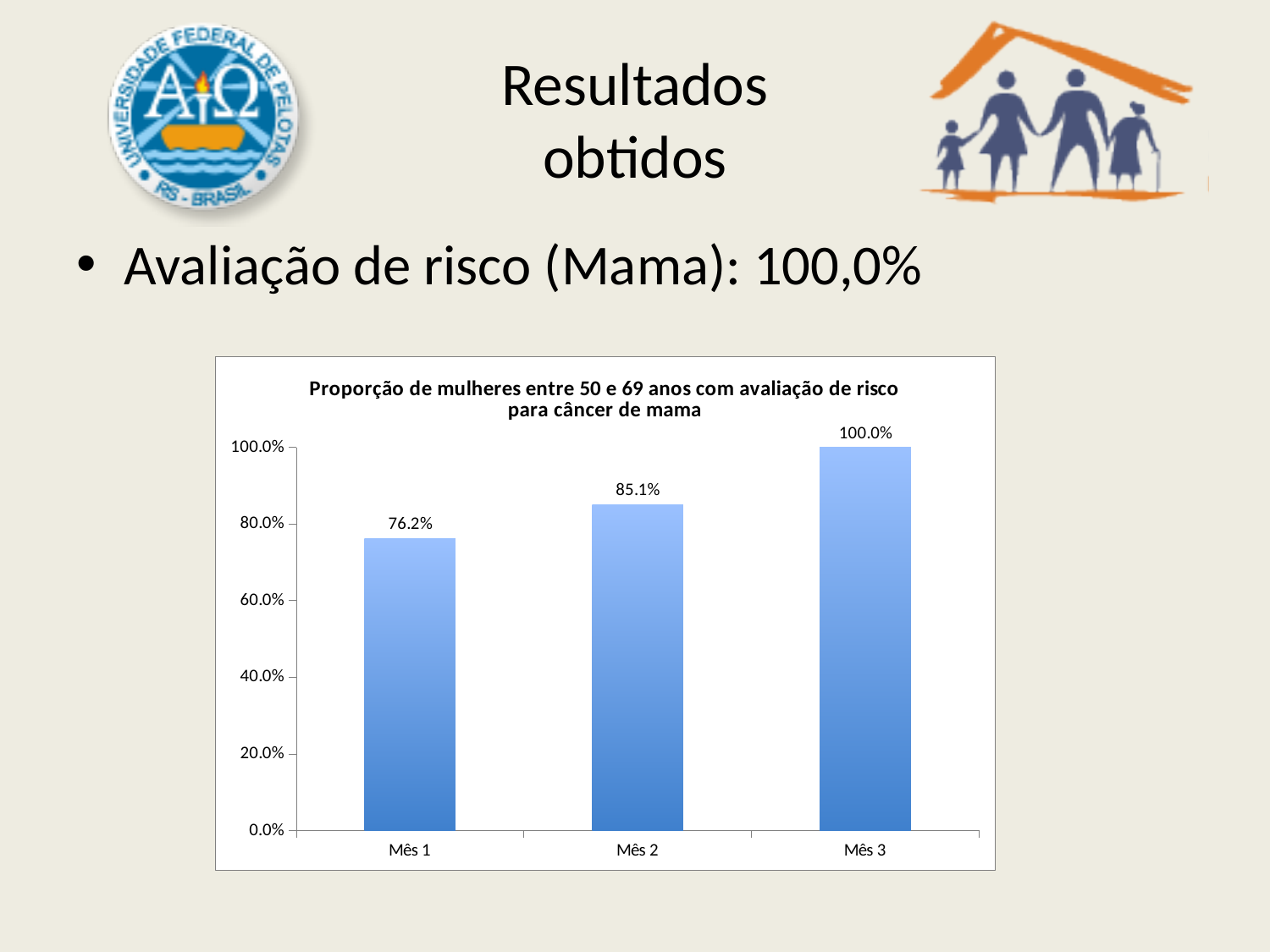
What is the difference between the values for Mês 2 and Mês 1? 8.9% What is the value for Mês 2? 85.1% Is the value for Mês 2 greater or less than 80.0%? greater What is the difference between the values for Mês 3 and Mês 1? 23.8% How many months are shown on the x axis? 3 What kind of chart is shown on the slide? bar chart Do the values rise or fall from Mês 1 to Mês 3? rise What is the value for Mês 3? 100.0% Which month has the lowest value? Mês 1 Which month has the highest value? Mês 3 Which is larger, the value for Mês 2 or the value for Mês 1? Mês 2 What is the value for Mês 1? 76.2%